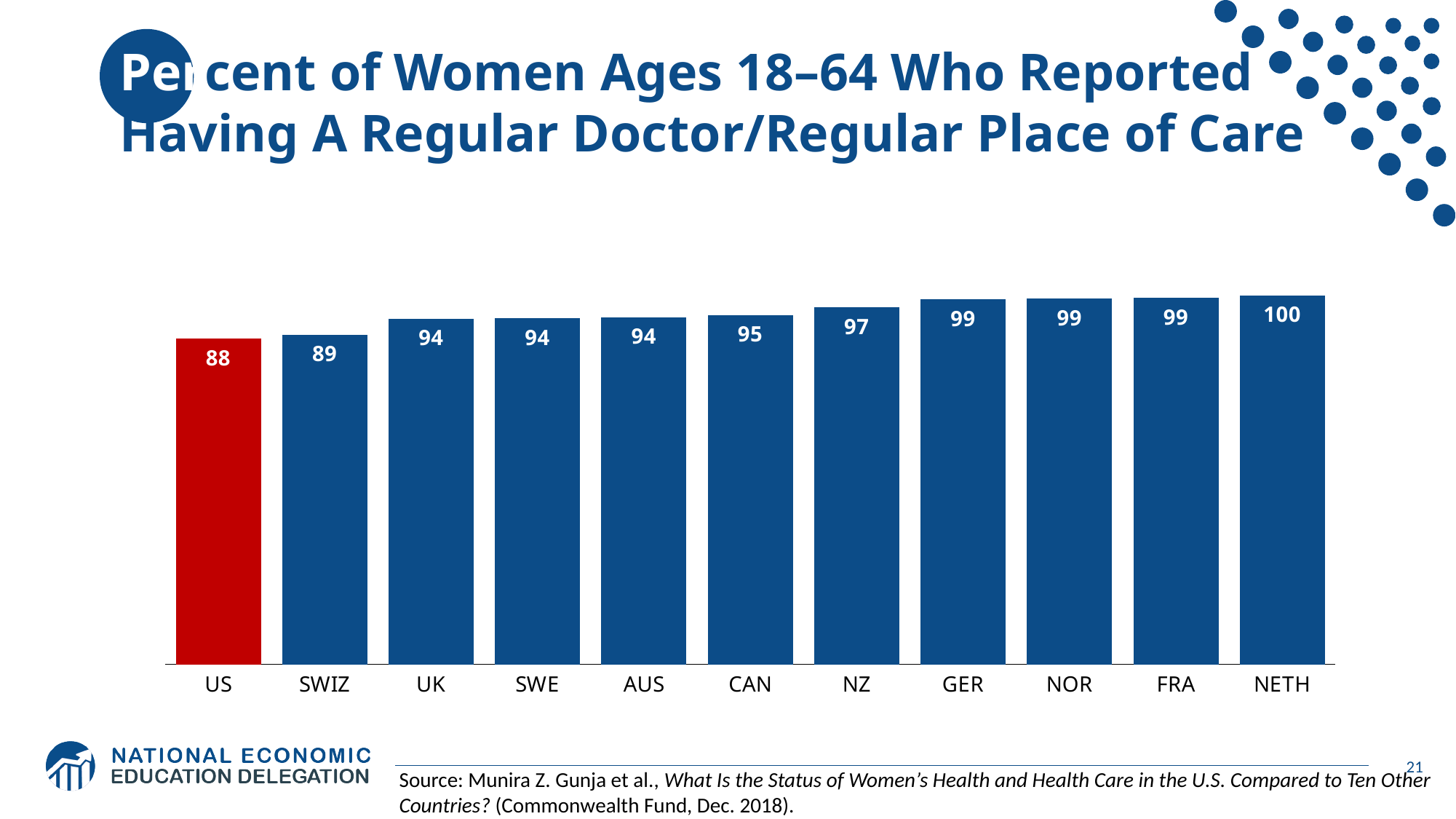
Which country has the lowest value? US Do the values rise or fall from left to right along the x axis? rise Which country has the highest value? NETH What is the value for NZ? 97 Which bar is coloured red rather than blue? US What is the value for the US? 88 Which has a larger value, CAN or SWIZ? CAN What kind of chart is shown on the slide? bar chart What is the value for CAN? 95 What is the difference between the values for SWIZ and UK? 5 What is the difference between the values for NETH and the US? 12 How many countries are shown in the chart? 11